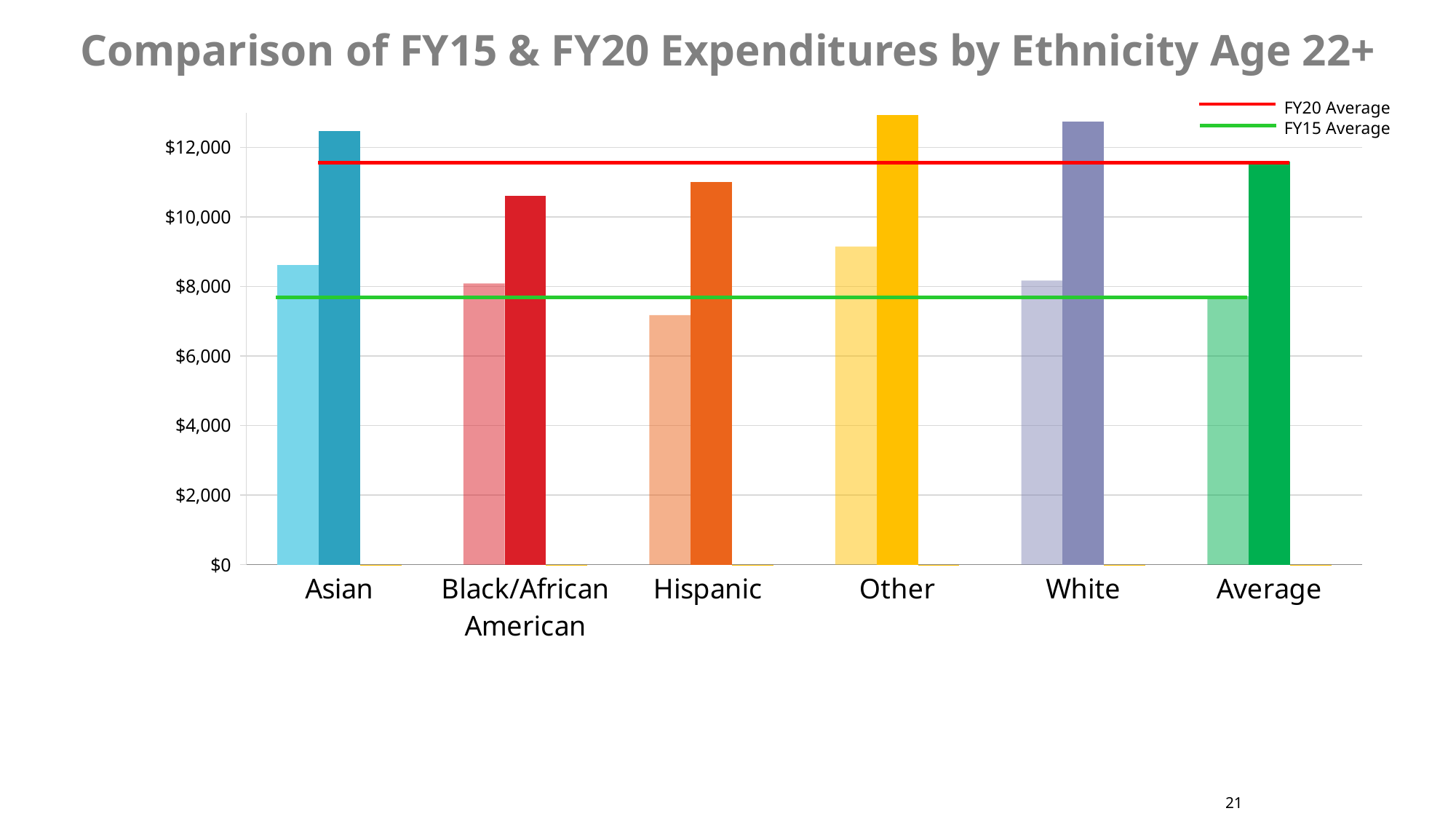
Is the value of the shorter (lighter) bar for Hispanic greater or less than $8,000? less Which category has the highest shorter (lighter) bar? Other Is the value of the taller (darker) bar for Average greater or less than $12,000? less How many entries does the legend list? 2 Is the value of the taller (darker) bar for Asian greater or less than $12,000? greater What kind of chart is shown on the slide? bar chart How many categories are shown along the x axis? 6 What is the title of the chart? Comparison of FY15 & FY20 Expenditures by Ethnicity Age 22+ Which is larger, the taller (darker) bar for Asian or the taller (darker) bar for Hispanic? Asian Which category has the lowest shorter (lighter) bar? Hispanic